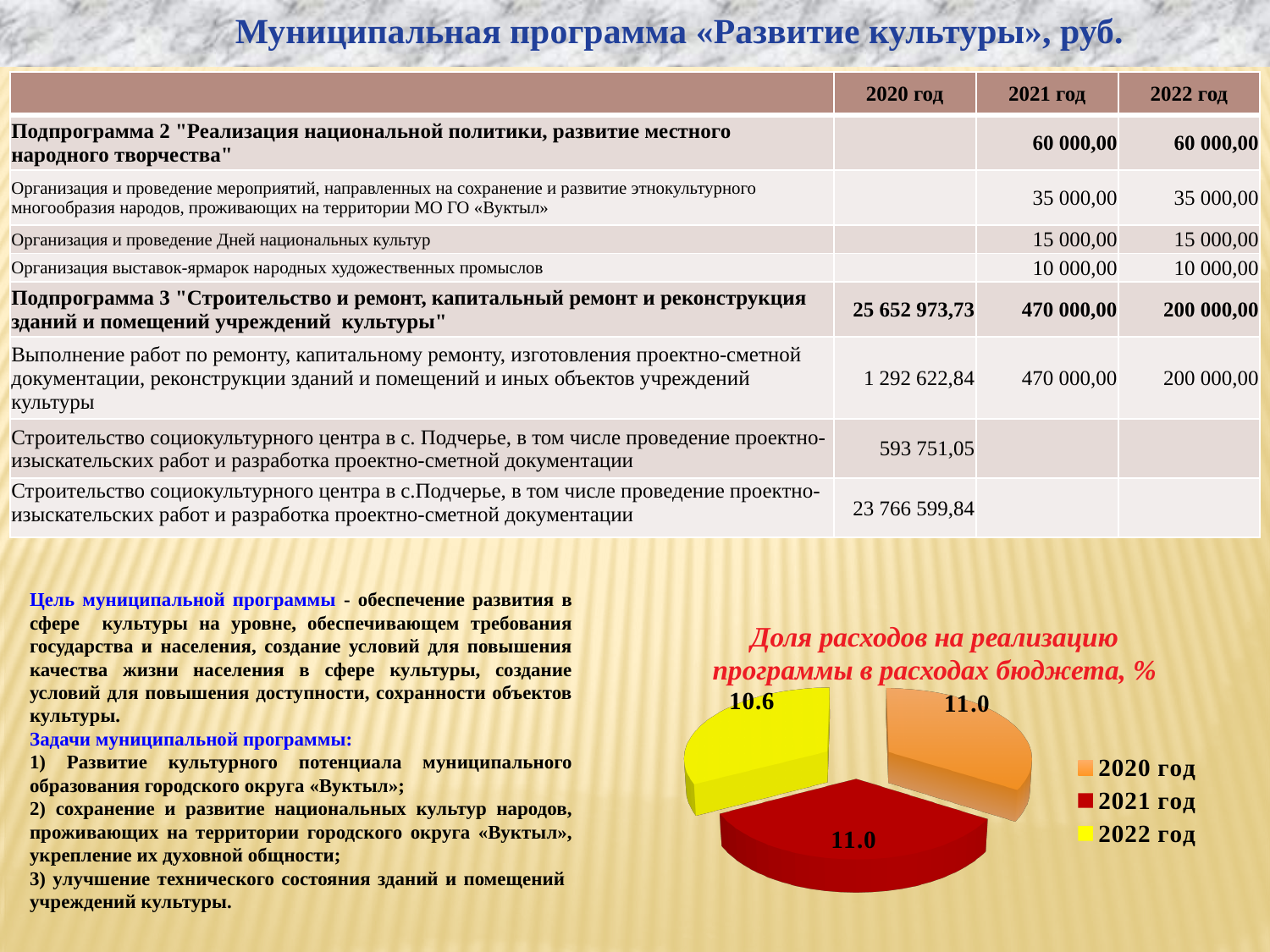
What is the value shown for 2020 год in the pie chart? 11.0 What colour is the slice for 2021 год in the pie chart? red Which year has the lowest value in the pie chart? 2022 год How many slices does the pie chart have? 3 What is the value shown for 2022 год in the pie chart? 10.6 What is the difference between the values for 2021 год and 2022 год in the pie chart? 0.4 Which is larger in the pie chart, the value for 2020 год or for 2022 год? 2020 год How many entries does the legend of the pie chart list? 3 What is the value shown for 2021 год in the pie chart? 11.0 What type of chart is shown on the slide? pie chart What is the title of the pie chart? Доля расходов на реализацию программы в расходах бюджета, %